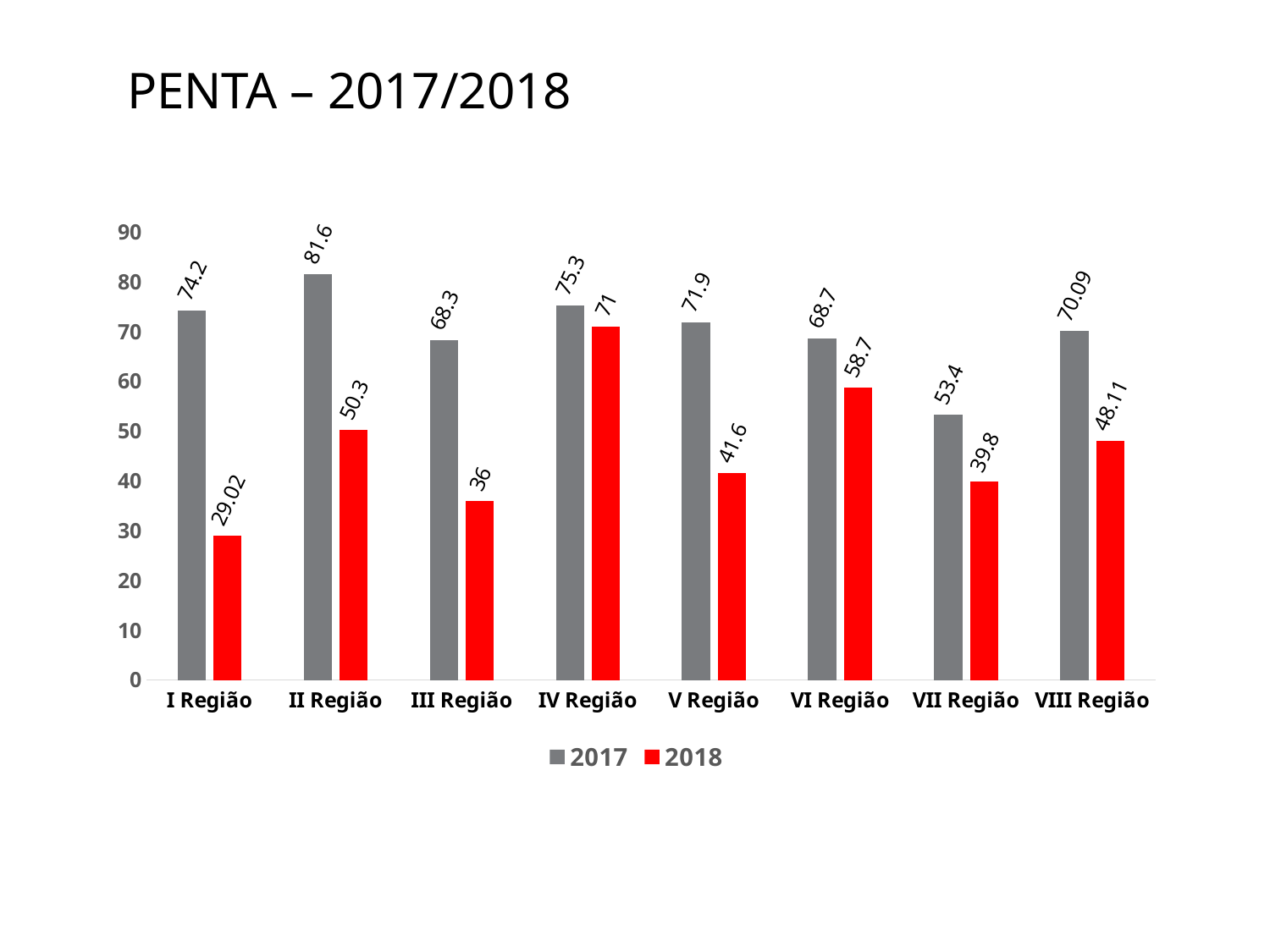
What colour are the 2018 bars? Red Which region has the lowest 2018 value? I Região Which is larger for V Região, the 2017 value or the 2018 value? 2017 How many regions are shown on the x axis? 8 What kind of chart is shown on the slide? Bar chart Which region has the lowest 2017 value? VII Região Which region has the highest 2017 value? II Região What is the difference between the 2017 and 2018 values for IV Região? 4.3 What is the 2018 value for I Região? 29.02 How many series does the legend list? 2 What is the 2018 value for VIII Região? 48.11 What is the 2017 value for II Região? 81.6